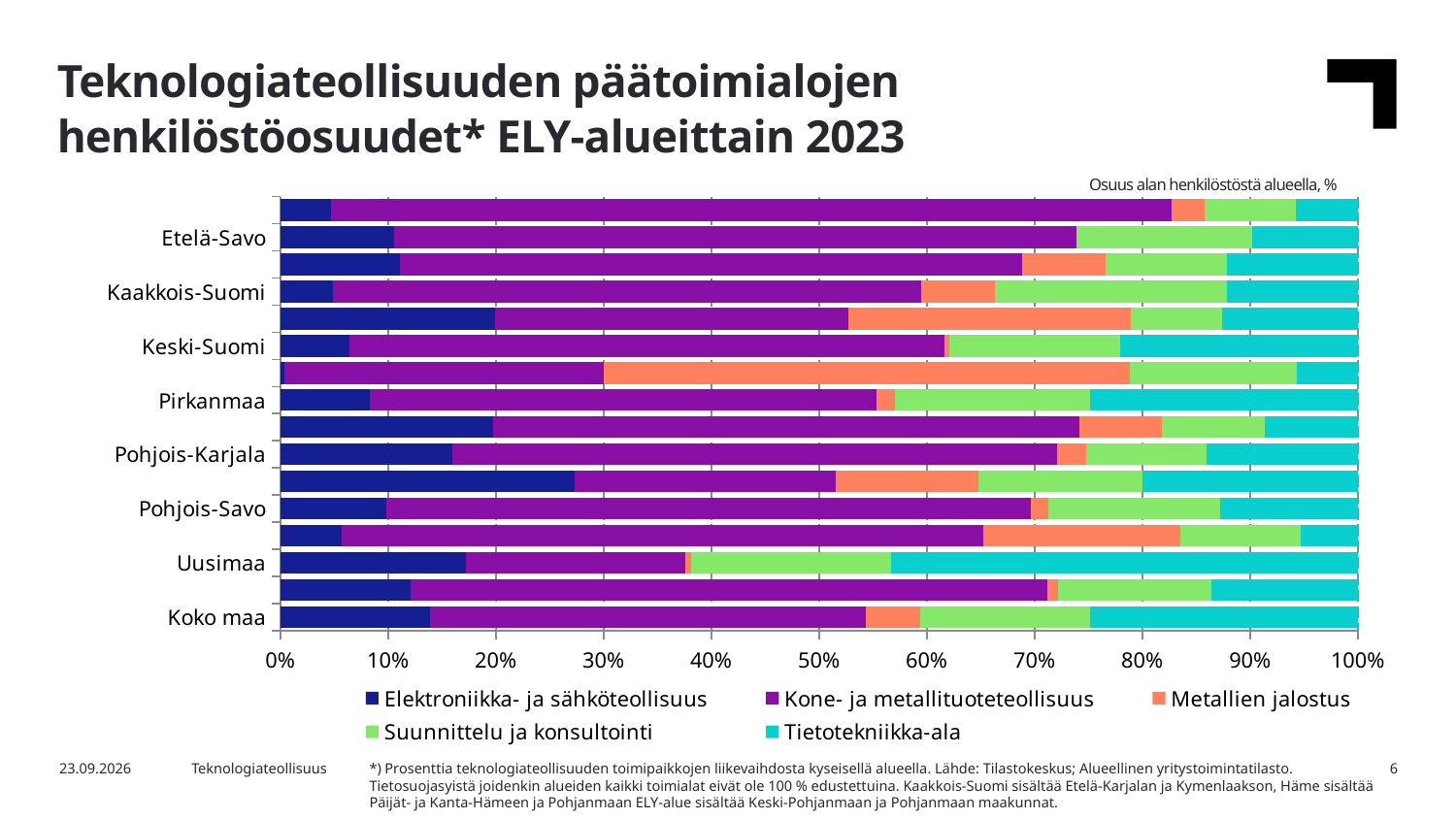
Which has the larger Kone- ja metallituoteteollisuus share, Uusimaa or Etelä-Savo? Etelä-Savo Is the Kone- ja metallituoteteollisuus share for Etelä-Savo greater or less than 50%? greater Which series is shown in orange in the legend? Metallien jalostus Is the Kone- ja metallituoteteollisuus share for Pohjois-Karjala greater or less than 50%? greater What kind of chart is shown on the slide? Stacked bar chart How many series does the legend list? 5 Which has the larger Tietotekniikka-ala share, Uusimaa or Koko maa? Uusimaa Is the Elektroniikka- ja sähköteollisuus share for Koko maa greater or less than 10%? greater What is the maximum value shown on the horizontal axis? 100% Among the labelled regions, which has the largest Tietotekniikka-ala share? Uusimaa